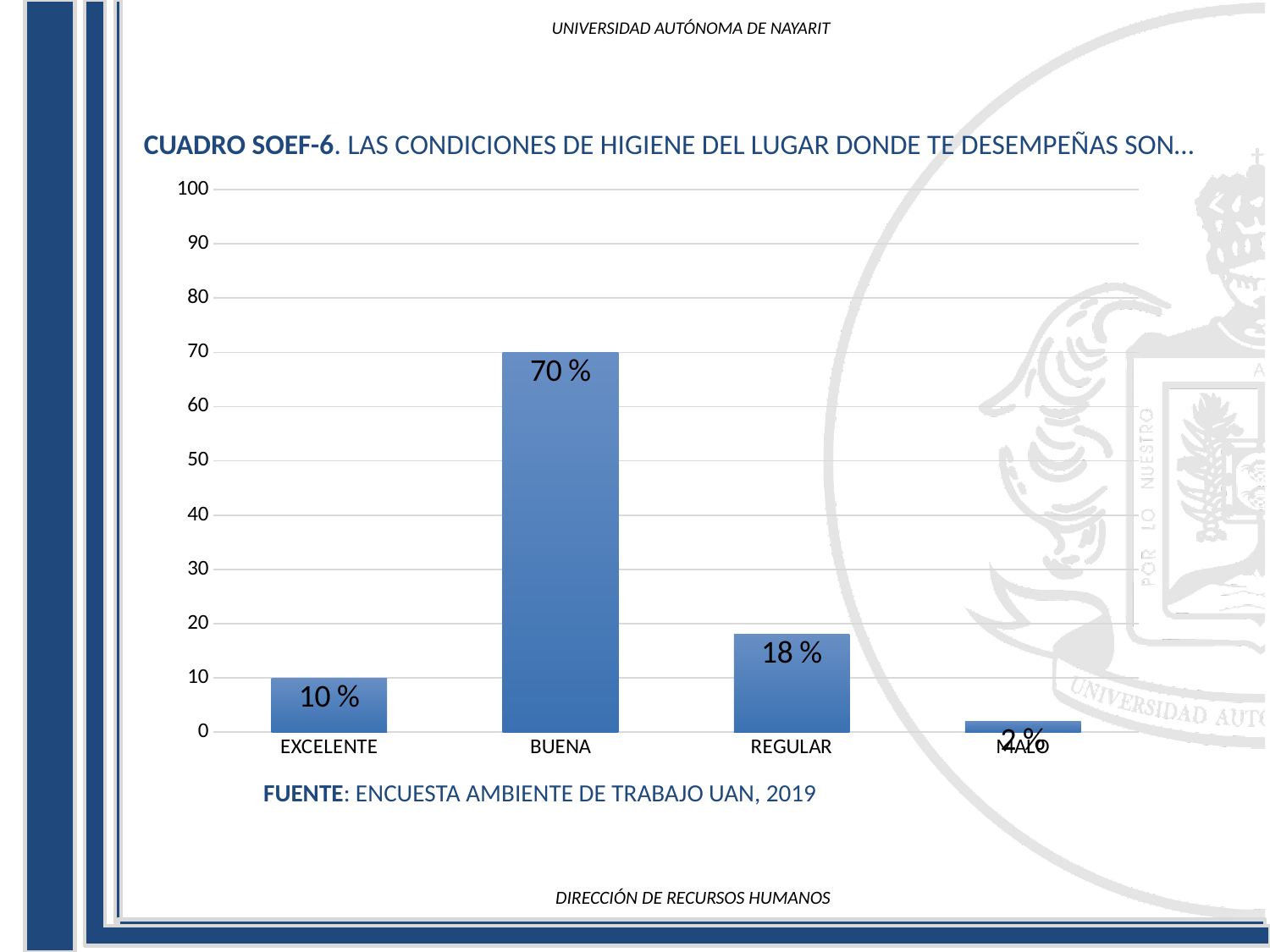
Which category has the lowest value? MALO What value is shown for EXCELENTE? 10 % What kind of chart is shown on the slide? bar chart What source is cited below the chart? ENCUESTA AMBIENTE DE TRABAJO UAN, 2019 Is the value for BUENA greater or less than 60? greater What is the difference between the values for BUENA and REGULAR? 52 % What value is shown for BUENA? 70 % Which is larger, the value for EXCELENTE or the value for REGULAR? REGULAR What value is shown for MALO? 2 % How many categories are shown on the x axis? 4 What value is shown for REGULAR? 18 % Which category has the highest value? BUENA